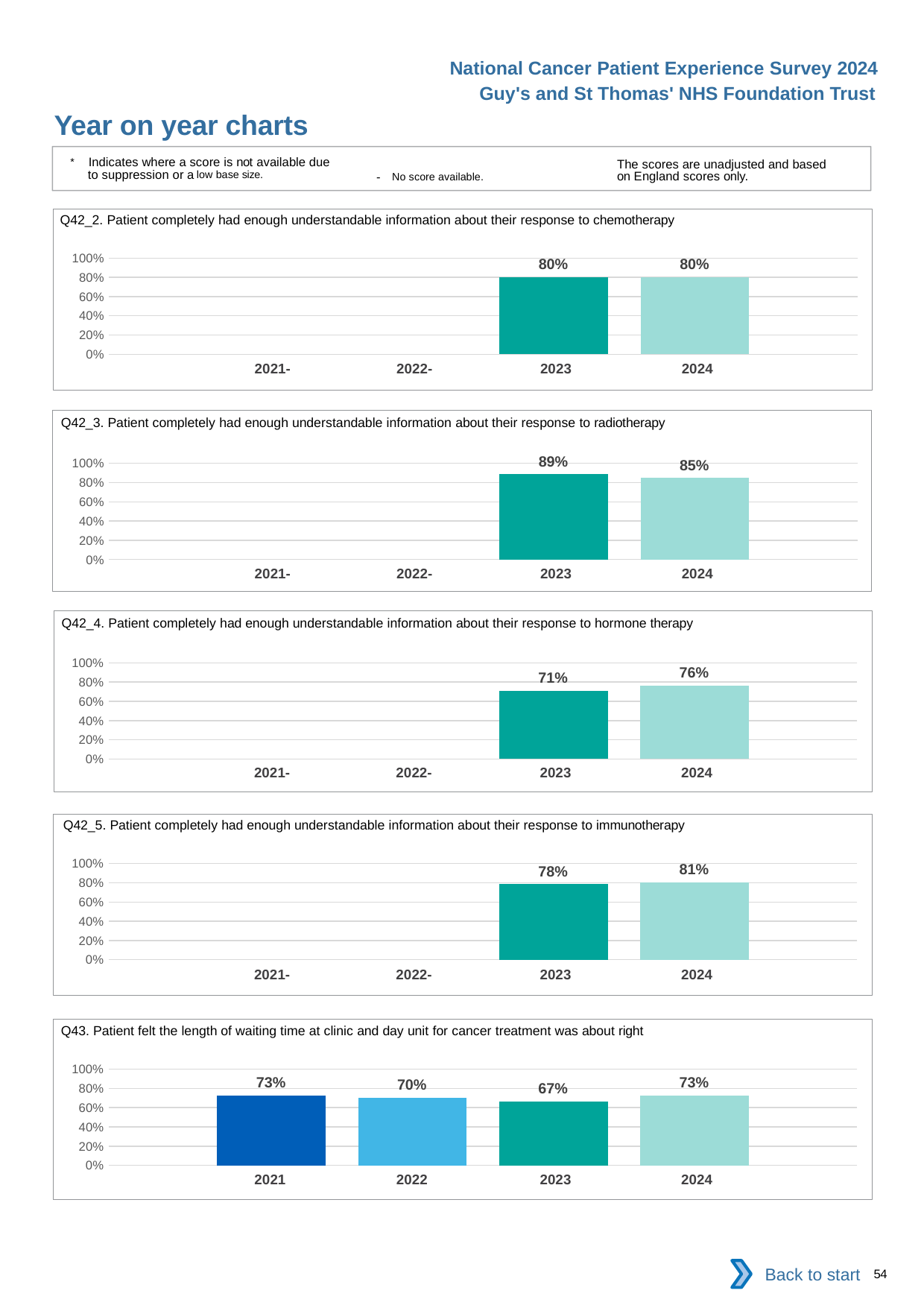
In the Q42_4 chart (hormone therapy), what is the value for 2023? 71% In the Q43 chart (waiting time at clinic and day unit), what is the value for 2022? 70% In the Q42_5 chart (immunotherapy), what is the difference between the 2024 and 2023 values? 3 percentage points In the Q43 chart (waiting time at clinic and day unit), which year has the lowest value? 2023 In the Q42_4 chart (hormone therapy), which year has the higher value, 2023 or 2024? 2024 In the Q43 chart (waiting time at clinic and day unit), is the value for 2023 greater or less than 80%? less In the Q42_3 chart (radiotherapy), what is the difference between the 2023 and 2024 values? 4 percentage points In the Q42_5 chart (immunotherapy), what is the value for 2024? 81% In the Q42_3 chart (radiotherapy), what is the value for 2023? 89% In the Q42_2 chart (chemotherapy), what is the value for 2024? 80% What type of chart is the Q42_2 chart (chemotherapy)? Bar chart In the Q43 chart (waiting time at clinic and day unit), how many bars are plotted? 4